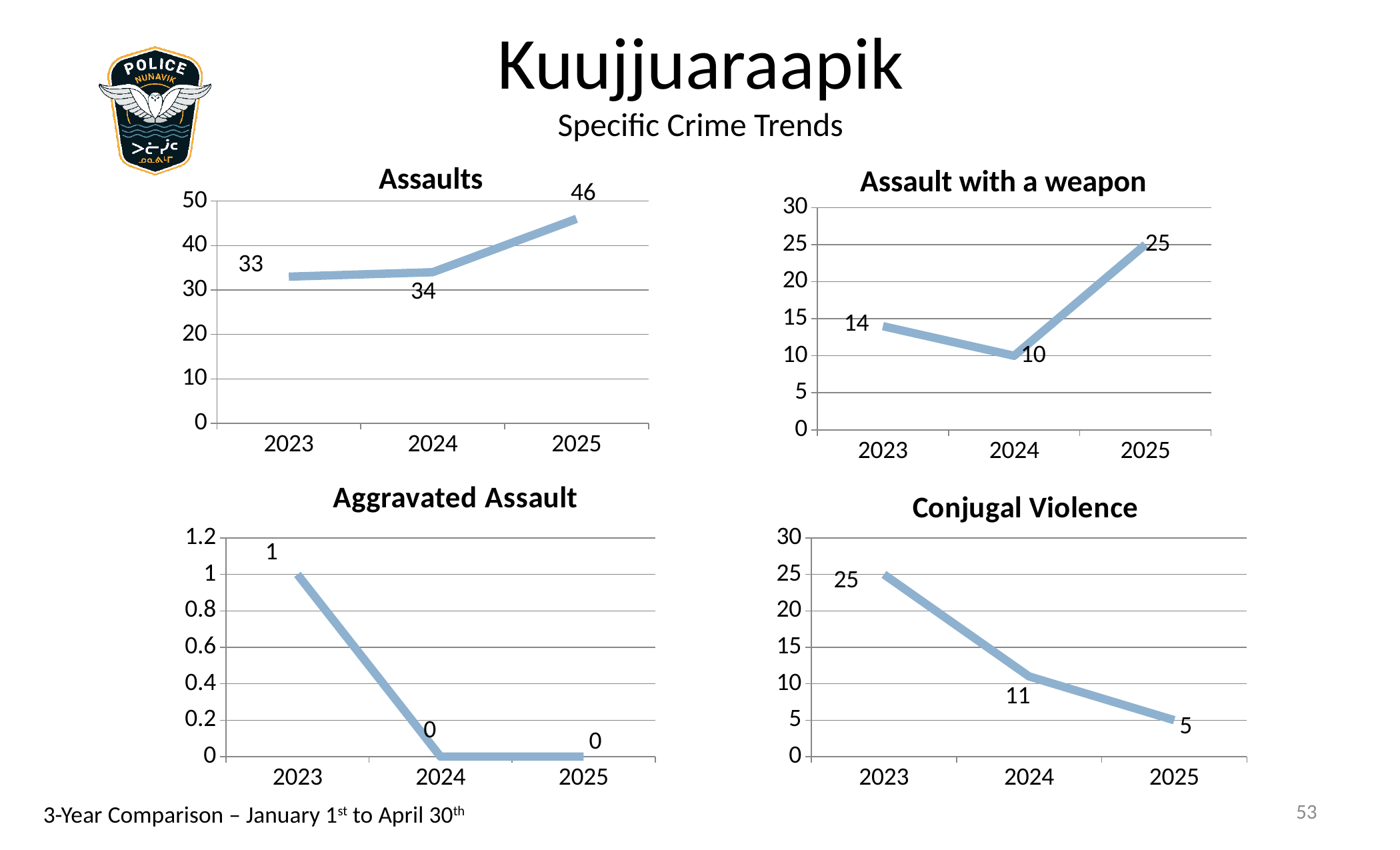
In the Assault with a weapon chart, which year has the highest value? 2025 What kind of chart is the Assaults chart? line chart In the Conjugal Violence chart, do the values rise or fall from 2023 to 2025? fall In the Conjugal Violence chart, what is the difference between the 2023 and 2025 values? 20 In the Assault with a weapon chart, is the value for 2023 larger or smaller than the value for 2024? larger In the Conjugal Violence chart, what is the value for 2024? 11 In the Aggravated Assault chart, how many years are plotted? 3 In the Assaults chart, what is the difference between the 2025 and 2023 values? 13 In the Assaults chart, which year has the lowest value? 2023 In the Assaults chart, what is the value for 2025? 46 In the Assault with a weapon chart, what is the value for 2024? 10 In the Aggravated Assault chart, what is the value for 2023? 1